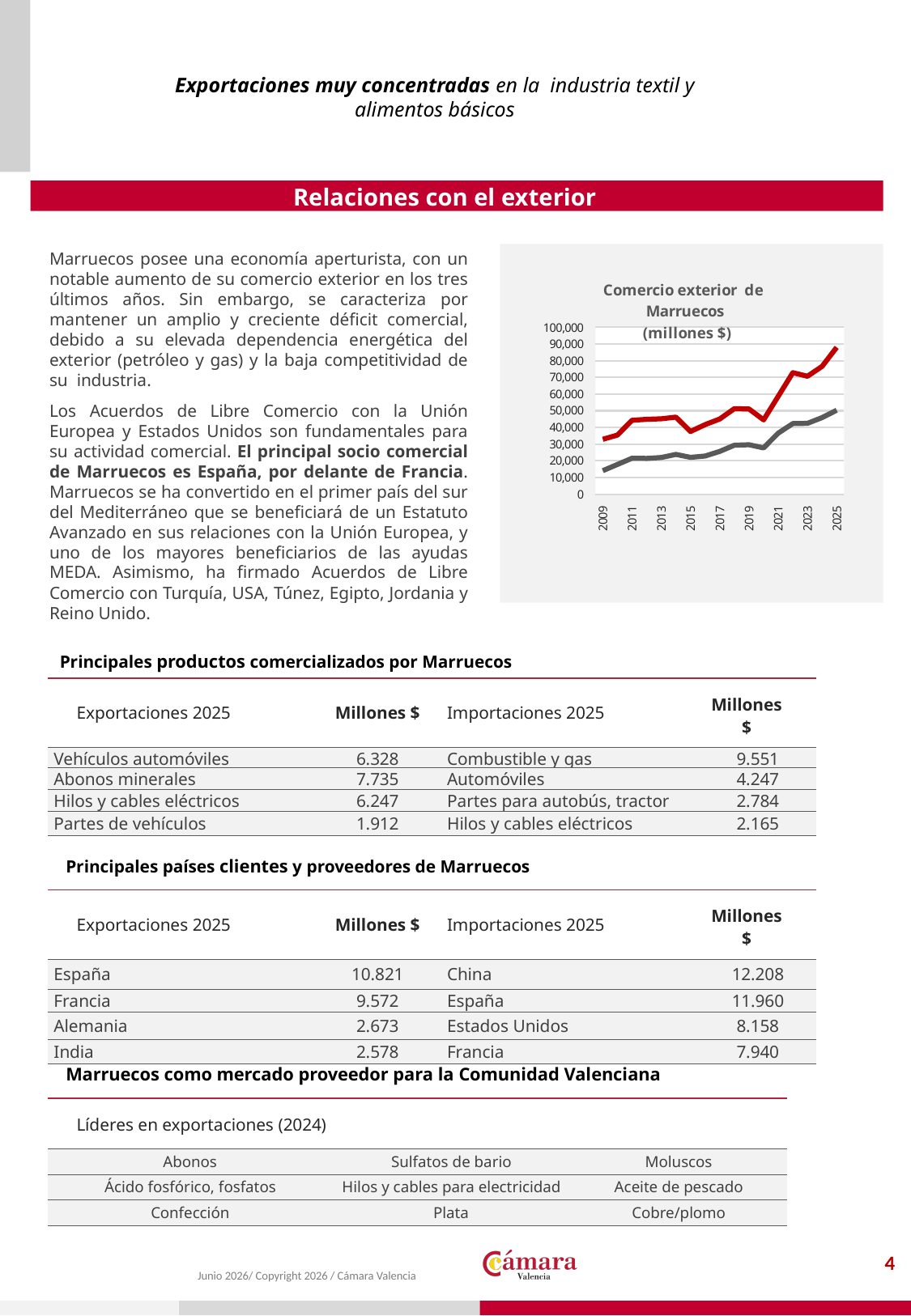
Is the value of the red line in 2025 greater or less than 80,000? greater Does the red line in the chart rise or fall overall from 2009 to 2025? rise What is the title of the chart on the slide? Comercio exterior de Marruecos (millones $) What kind of chart is shown on the slide? line chart Is the value of the grey line in 2009 greater or less than 20,000? less Is the value of the grey line in 2025 greater or less than 40,000? greater How many year labels are shown on the x axis of the chart? 9 Does the grey line in the chart rise or fall overall from 2009 to 2025? rise What is the highest value shown on the y axis of the chart? 100,000 In 2025, which line has the higher value, the red line or the grey line? the red line